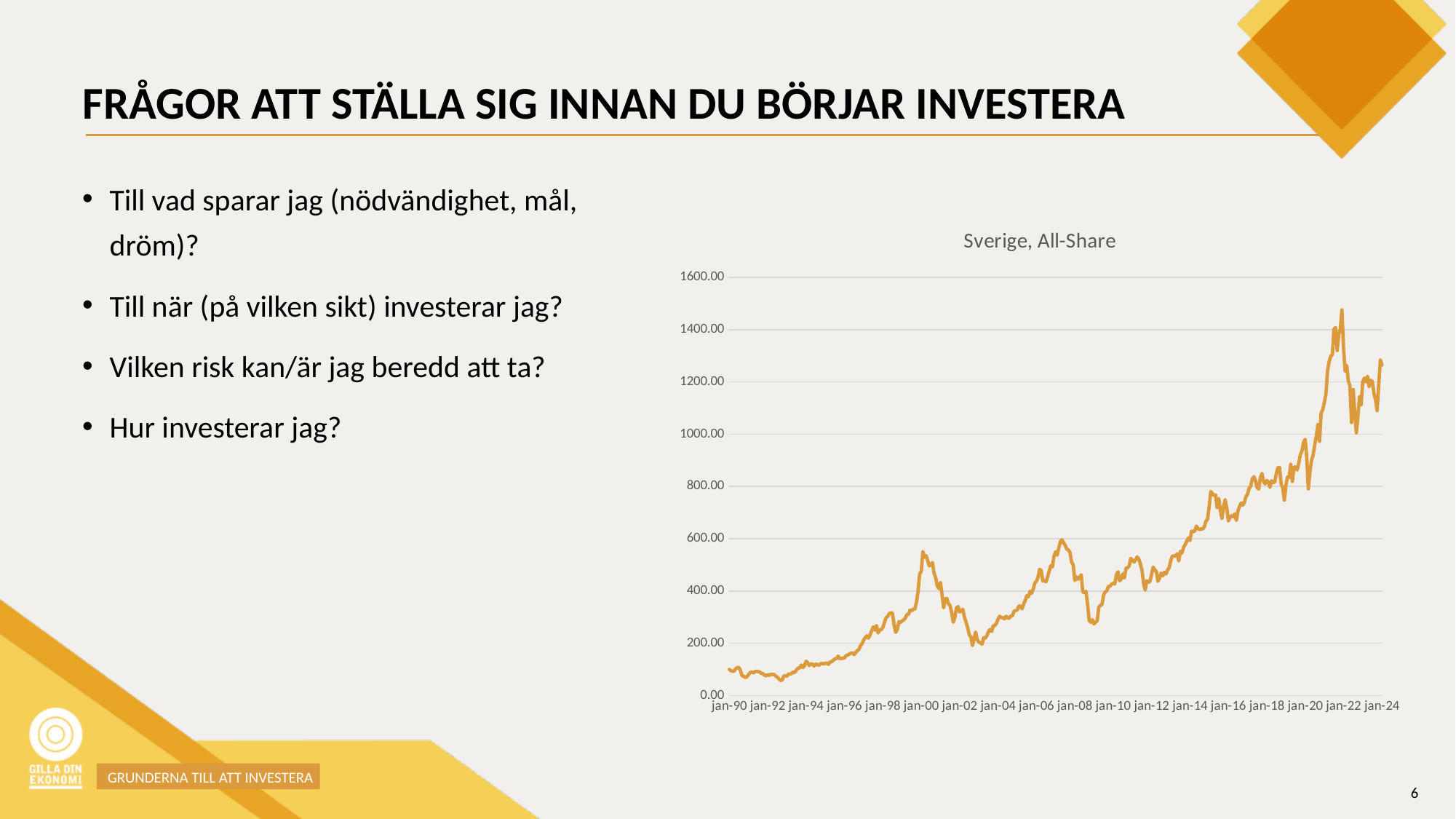
How many date labels are shown on the x axis? 18 Is the value at jan-20 greater or less than 800.00? greater Which is larger, the value at jan-90 or the value at jan-24? jan-24 Is the value at jan-90 greater or less than 200.00? less Is the value at jan-16 greater or less than 600.00? greater What is the title of the chart? Sverige, All-Share Which is larger, the value at jan-00 or the value at jan-20? jan-20 What kind of chart is shown on the slide? line chart Overall, do the values in the chart rise or fall from jan-90 to jan-24? rise What is the highest value shown on the y axis? 1600.00